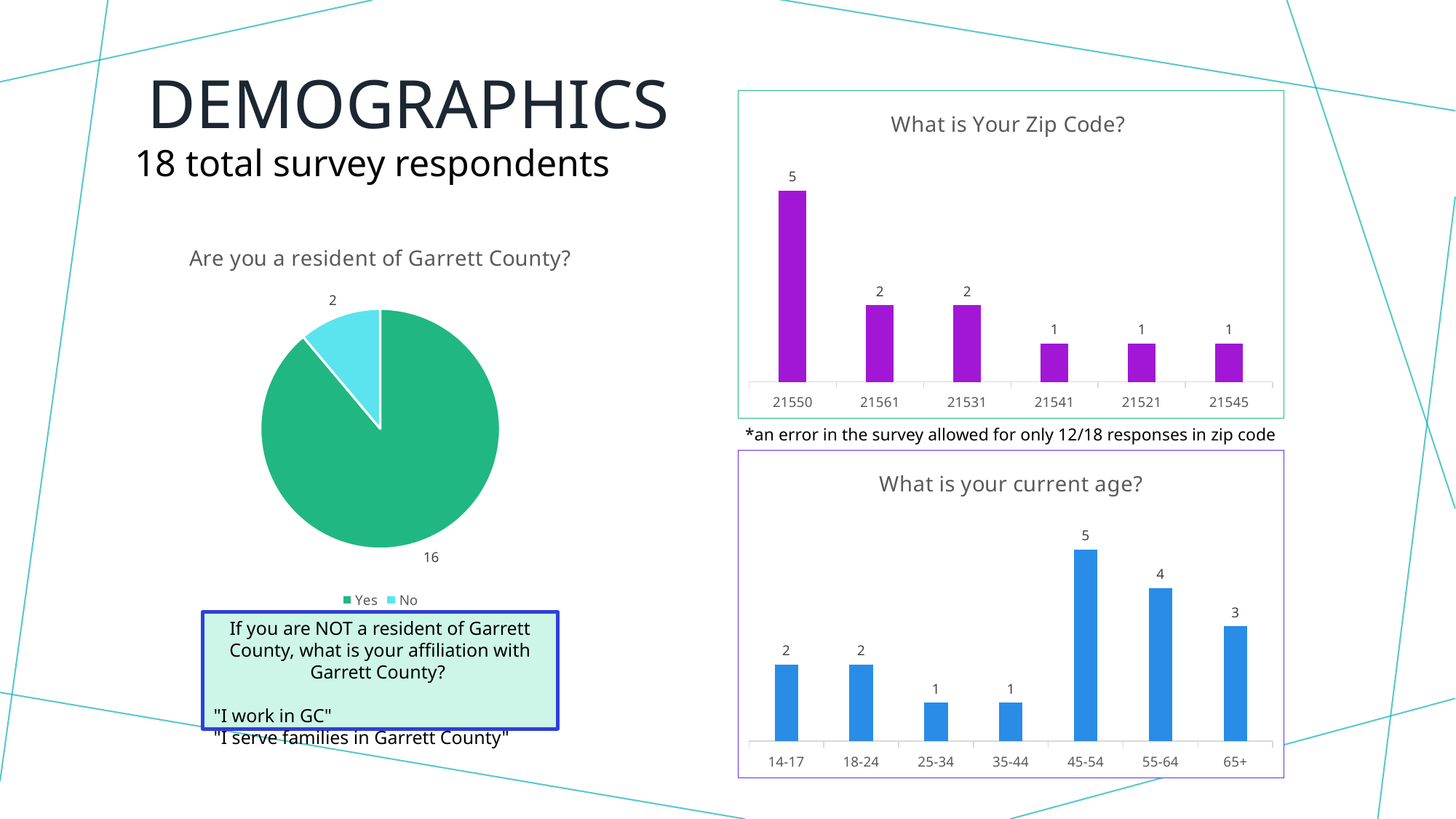
What kind of chart is 'Are you a resident of Garrett County?' Pie chart In the 'What is Your Zip Code?' chart, what is the value for 21561? 2 In the 'Are you a resident of Garrett County?' chart, how many entries does the legend list? 2 In the 'What is Your Zip Code?' chart, what is the difference between the values for 21550 and 21541? 4 In the 'What is your current age?' chart, what is the value for 55-64? 4 In the 'What is your current age?' chart, which age group has the highest value? 45-54 In the 'What is your current age?' chart, which is larger, the value for 65+ or the value for 18-24? 65+ In the 'Are you a resident of Garrett County?' chart, how many respondents answered Yes? 16 In the 'What is Your Zip Code?' chart, which zip code has the highest value? 21550 In the 'What is Your Zip Code?' chart, how many zip code categories are shown? 6 What kind of chart is 'What is your current age?' Bar chart In the 'Are you a resident of Garrett County?' chart, how many respondents answered No? 2